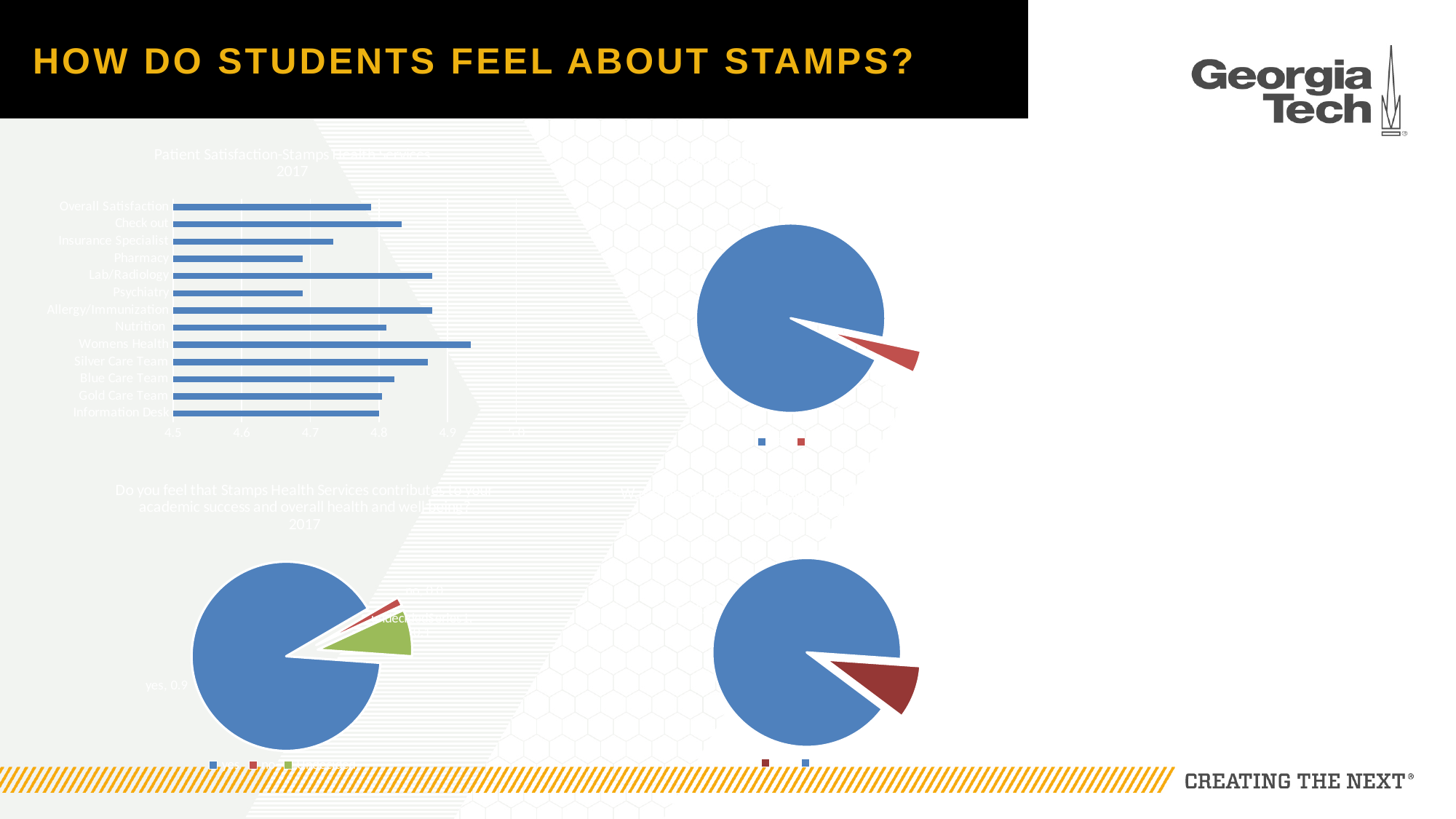
In the 'Patient Satisfaction-Stamps Health Services 2017' bar chart, is the value for Womens Health greater or less than 4.9? greater In the bottom-left pie chart about whether Stamps Health Services contributes to academic success, how many entries does the legend list? 3 In the 'Patient Satisfaction-Stamps Health Services 2017' bar chart, is the value for Insurance Specialist greater or less than 4.8? less In the 'Patient Satisfaction-Stamps Health Services 2017' bar chart, which category has the highest value? Womens Health What kind of chart is the bottom-left chart titled 'Do you feel that Stamps Health Services contributes to your academic success and overall health and well-being? 2017'? pie chart In the 'Patient Satisfaction-Stamps Health Services 2017' bar chart, how many categories are plotted? 13 In the 'Patient Satisfaction-Stamps Health Services 2017' bar chart, which is larger, the value for Check out or the value for Psychiatry? Check out What kind of chart is the 'Patient Satisfaction-Stamps Health Services 2017' chart at the top left? bar chart In the 'Patient Satisfaction-Stamps Health Services 2017' bar chart, is the value for Lab/Radiology greater or less than 4.8? greater In the bottom-left pie chart about whether Stamps Health Services contributes to academic success, what share is labelled for 'yes'? 0.9 In the 'Patient Satisfaction-Stamps Health Services 2017' bar chart, which is larger, the value for Silver Care Team or the value for Pharmacy? Silver Care Team